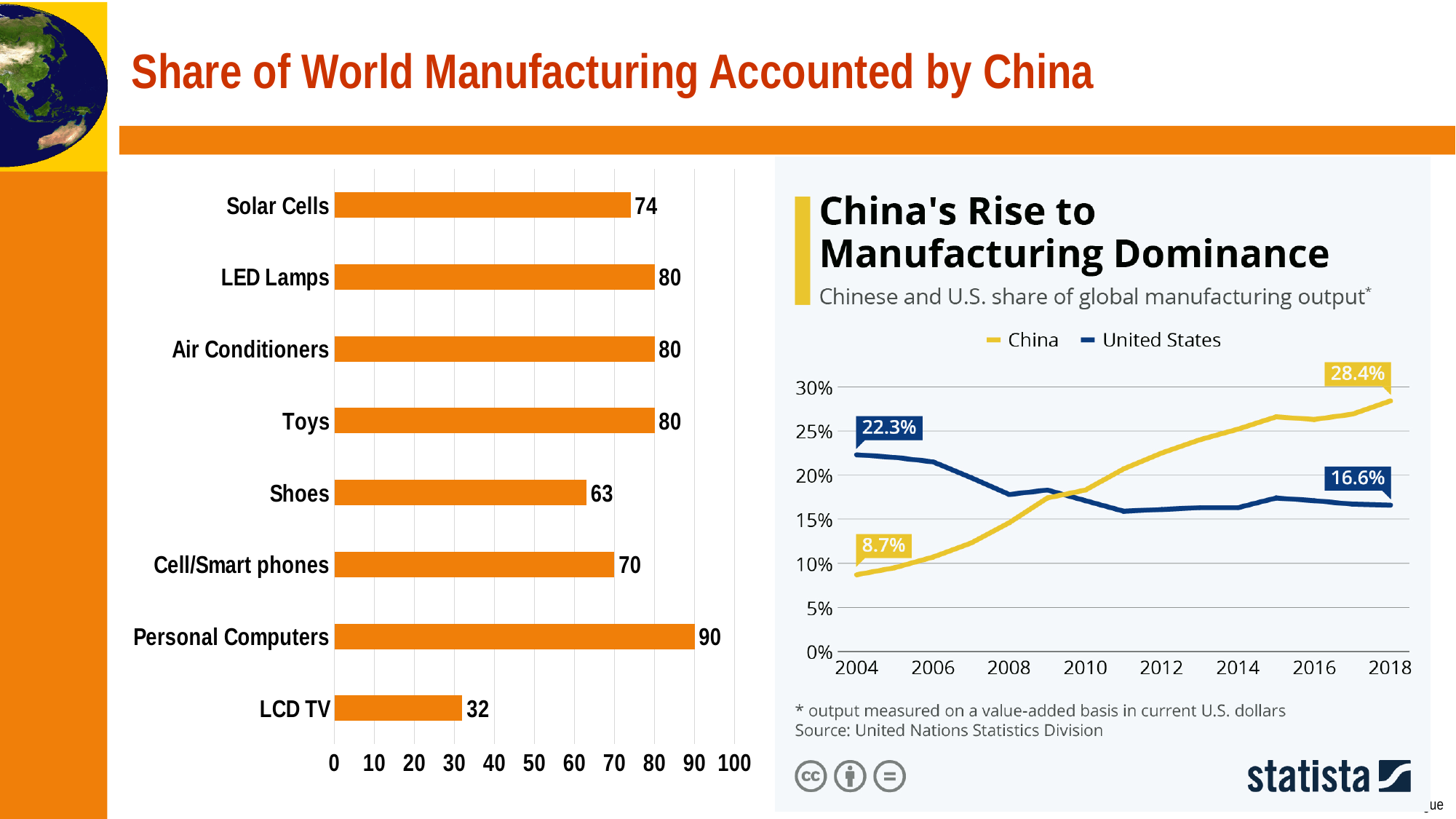
How many series does the legend list in the 'China's Rise to Manufacturing Dominance' chart? 2 In the 'China's Rise to Manufacturing Dominance' chart, what is the United States' share in 2004? 22.3% In the bar chart on the left, which category has the lowest value? LCD TV What kind of chart is the chart on the left? Bar chart In the bar chart on the left, which is larger, the value for Cell/Smart phones or the value for Shoes? Cell/Smart phones In the bar chart on the left, what is the value for Personal Computers? 90 In the 'China's Rise to Manufacturing Dominance' chart, what is China's share in 2018? 28.4% How many categories are shown in the bar chart on the left? 8 In the bar chart on the left, which category has the highest value? Personal Computers In the bar chart on the left, what is the value for Shoes? 63 In the bar chart on the left, what is the difference between the values for Solar Cells and LCD TV? 42 In the 'China's Rise to Manufacturing Dominance' chart, does China's share rise or fall from 2004 to 2018? Rise